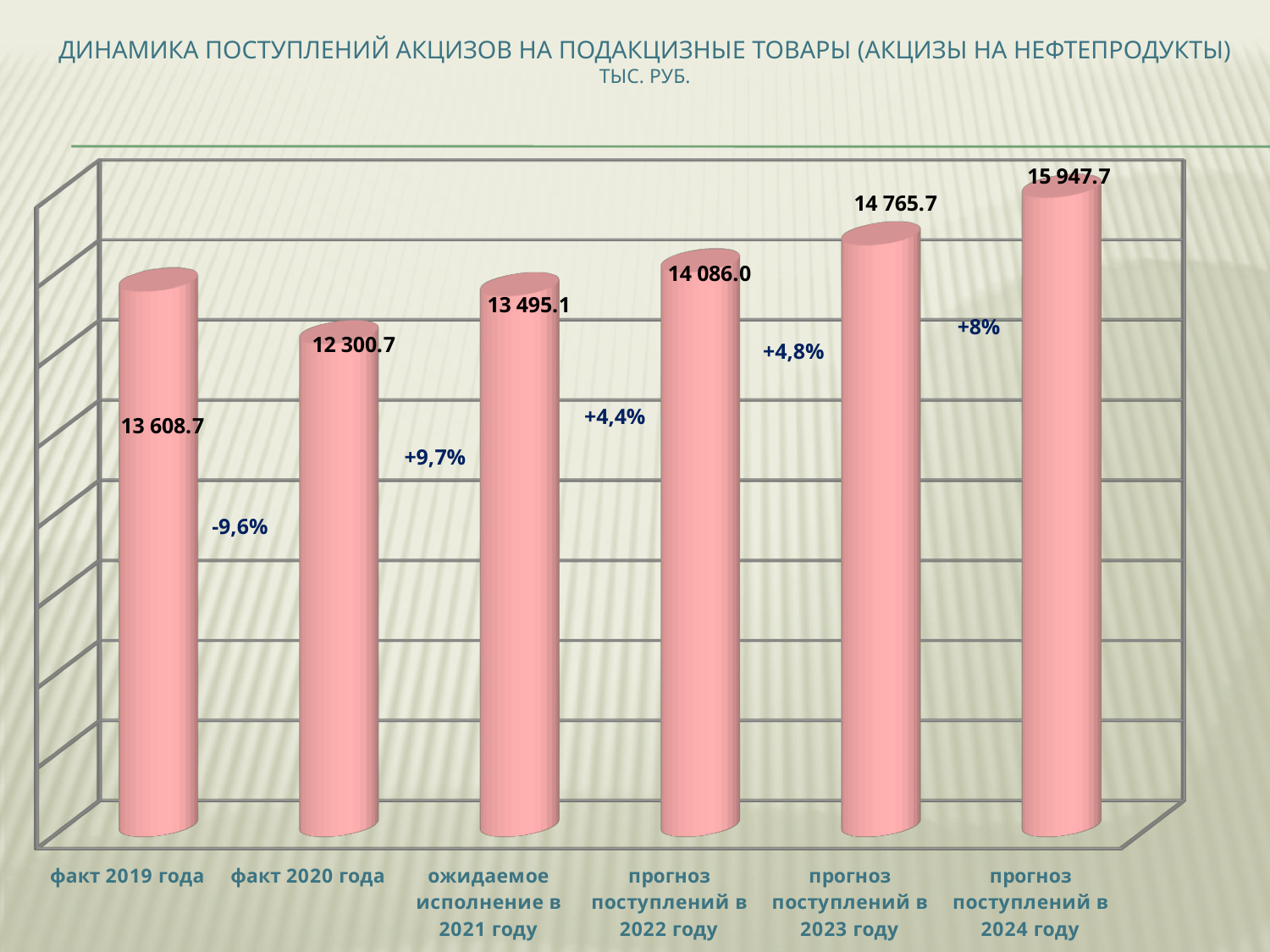
What is the difference between the values for факт 2019 года and факт 2020 года? 1 308.0 What is the difference between the values for прогноз поступлений в 2024 году and прогноз поступлений в 2023 году? 1 182.0 What percentage change is shown between факт 2019 года and факт 2020 года? -9,6% Which is larger, the value for факт 2019 года or the value for ожидаемое исполнение в 2021 году? факт 2019 года Which category has the lowest value? факт 2020 года What is the value for ожидаемое исполнение в 2021 году? 13 495.1 Which category has the highest value? прогноз поступлений в 2024 году What is the value for прогноз поступлений в 2024 году? 15 947.7 What kind of chart is this? bar chart What is the value for факт 2019 года? 13 608.7 How many categories are shown on the chart? 6 From факт 2020 года to прогноз поступлений в 2024 году, do the values rise or fall? rise